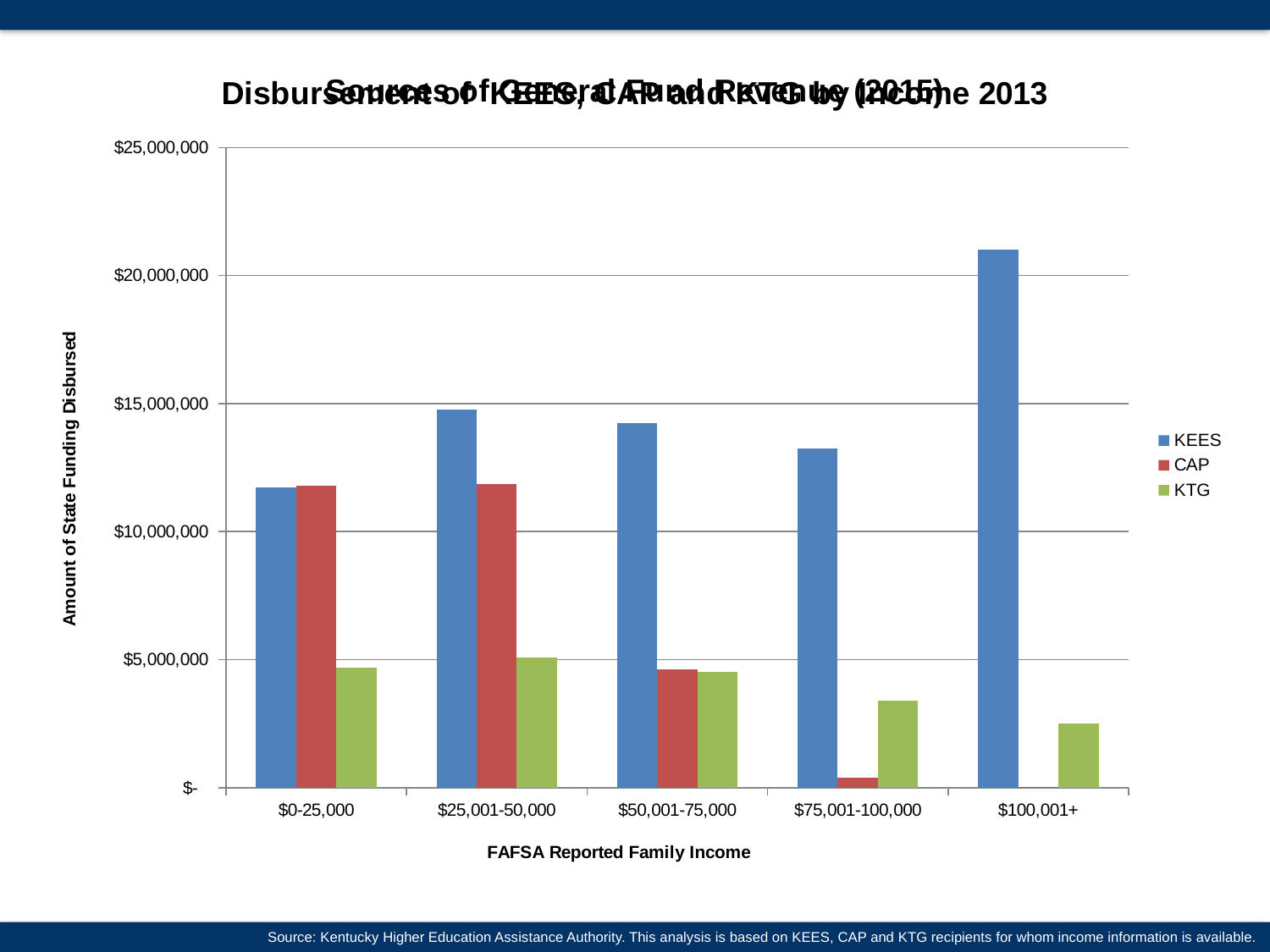
Is the KTG value for $0-25,000 greater or less than $5,000,000? less For the $75,001-100,000 category, which is larger, CAP or KTG? KTG Is the KEES value for $75,001-100,000 greater or less than $10,000,000? greater For the $50,001-75,000 category, which is larger, KEES or CAP? KEES Which income category has the highest KEES value? $100,001+ How many income categories are shown on the x axis? 5 How many series does the legend list? 3 Is the KEES value for $100,001+ greater or less than $20,000,000? greater What is the title of the x axis? FAFSA Reported Family Income Which income category has the lowest CAP value? $100,001+ Which income category has the lowest KEES value? $0-25,000 What kind of chart is shown on the slide? bar chart